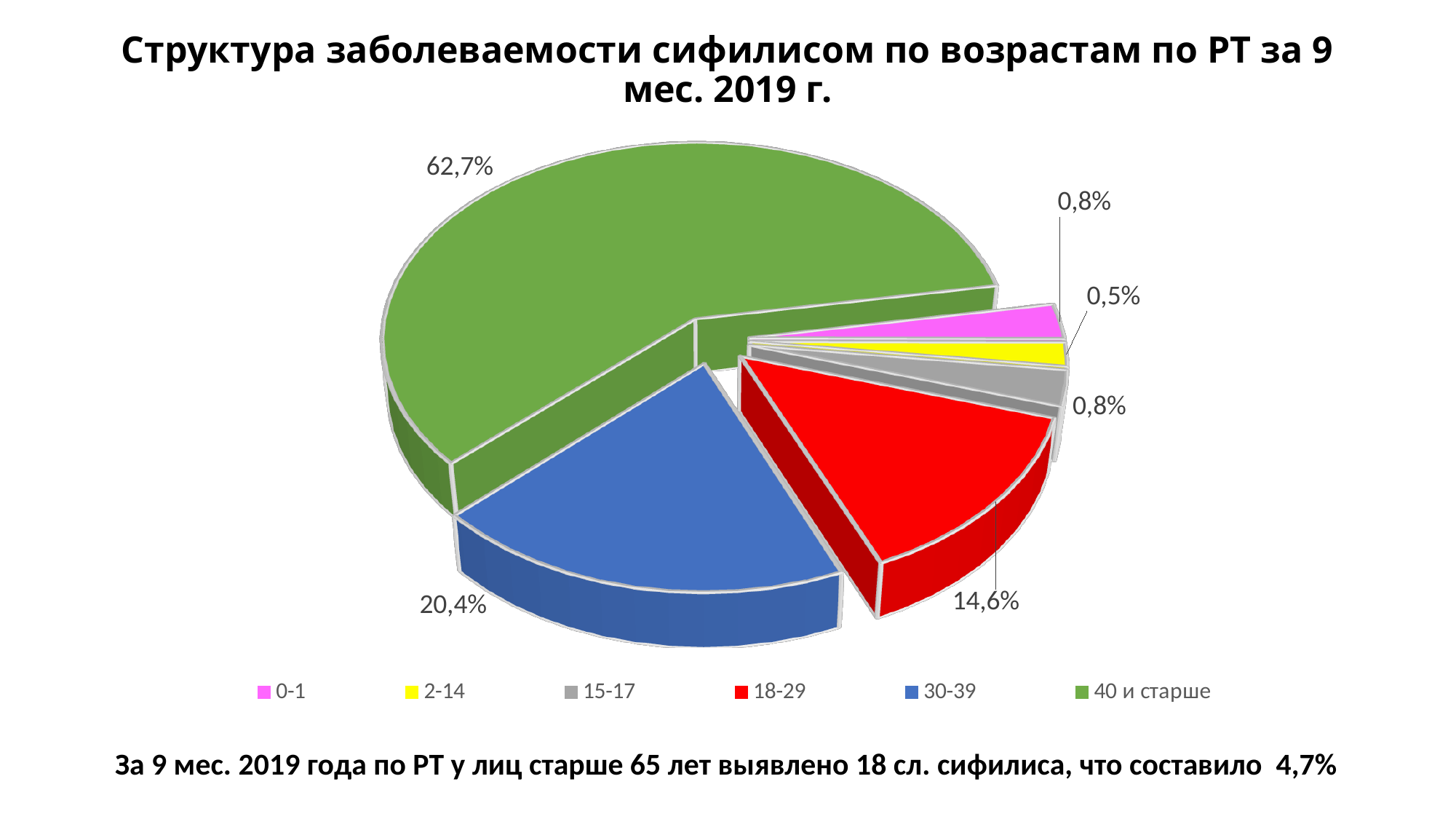
What is the value shown for the "2-14" age group? 0,5% What share of the pie does the "40 и старше" age group have? 62,7% What colour is the slice for the "18-29" age group? Red What is the difference between the shares of the "30-39" and "18-29" age groups? 5,8% What kind of chart is shown on the slide? Pie chart Which age group has the smallest share of the pie? 2-14 What is the value shown for the "0-1" age group? 0,8% What is the value shown for the "18-29" age group? 14,6% Which age group has a larger share: "30-39" or "18-29"? 30-39 Which age group has the largest share of the pie? 40 и старше How many age groups does the legend list? 6 What is the value shown for the "30-39" age group? 20,4%